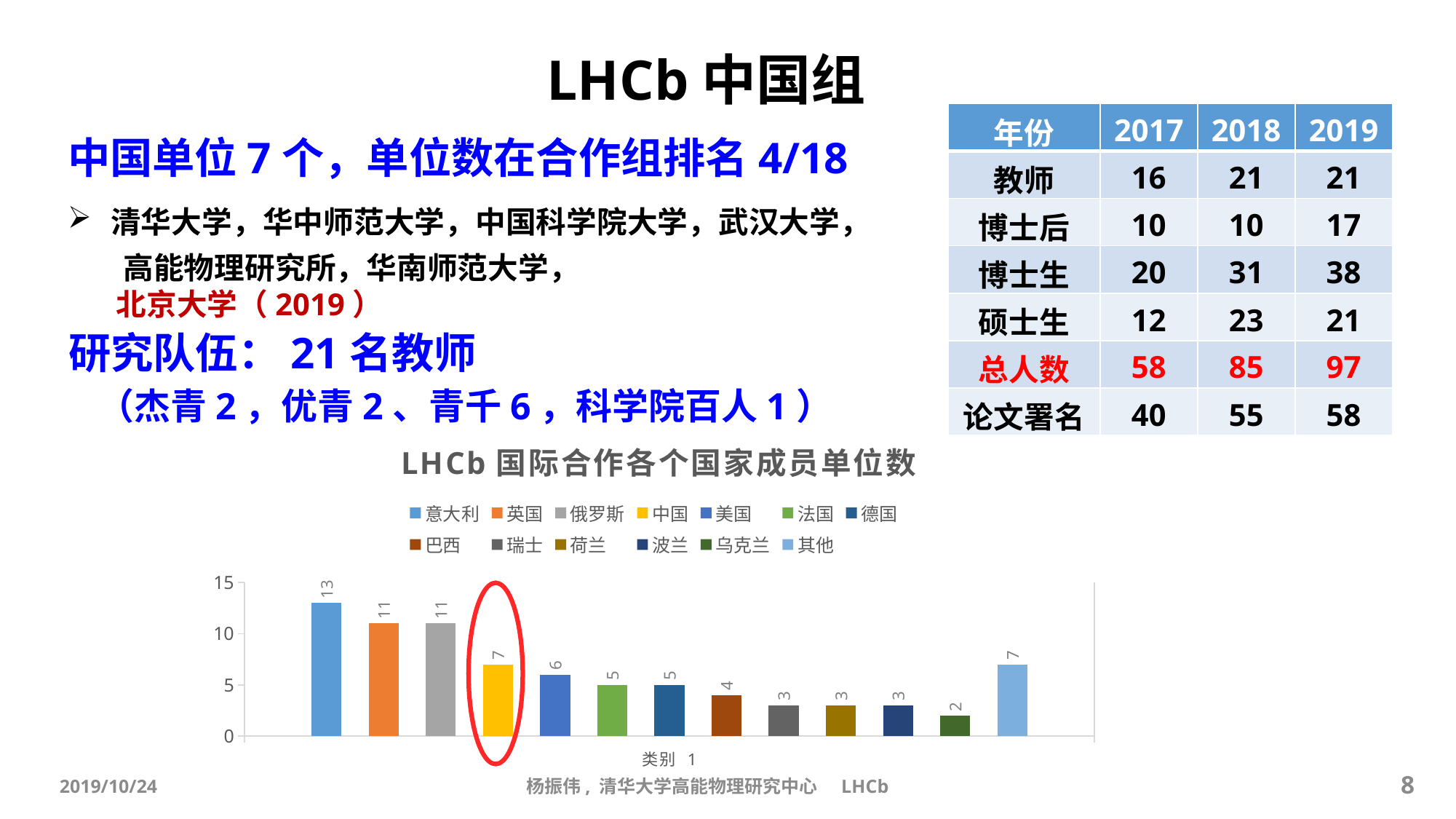
What is the value for 中国 in the chart LHCb 国际合作各个国家成员单位数? 7 Which country's bar is circled in red in the chart? 中国 What kind of chart is shown on the slide? bar chart Which country has the lowest value in the chart? 乌克兰 What is the difference between the values for 意大利 and 中国? 6 Which is larger, the value for 英国 or the value for 美国? 英国 How many bars are plotted in the chart? 13 What is the value for 乌克兰 in the chart? 2 How many entries does the chart legend list? 13 What is the value for 巴西 in the chart? 4 Which country has the highest value in the chart? 意大利 What is the value for 意大利 in the chart? 13